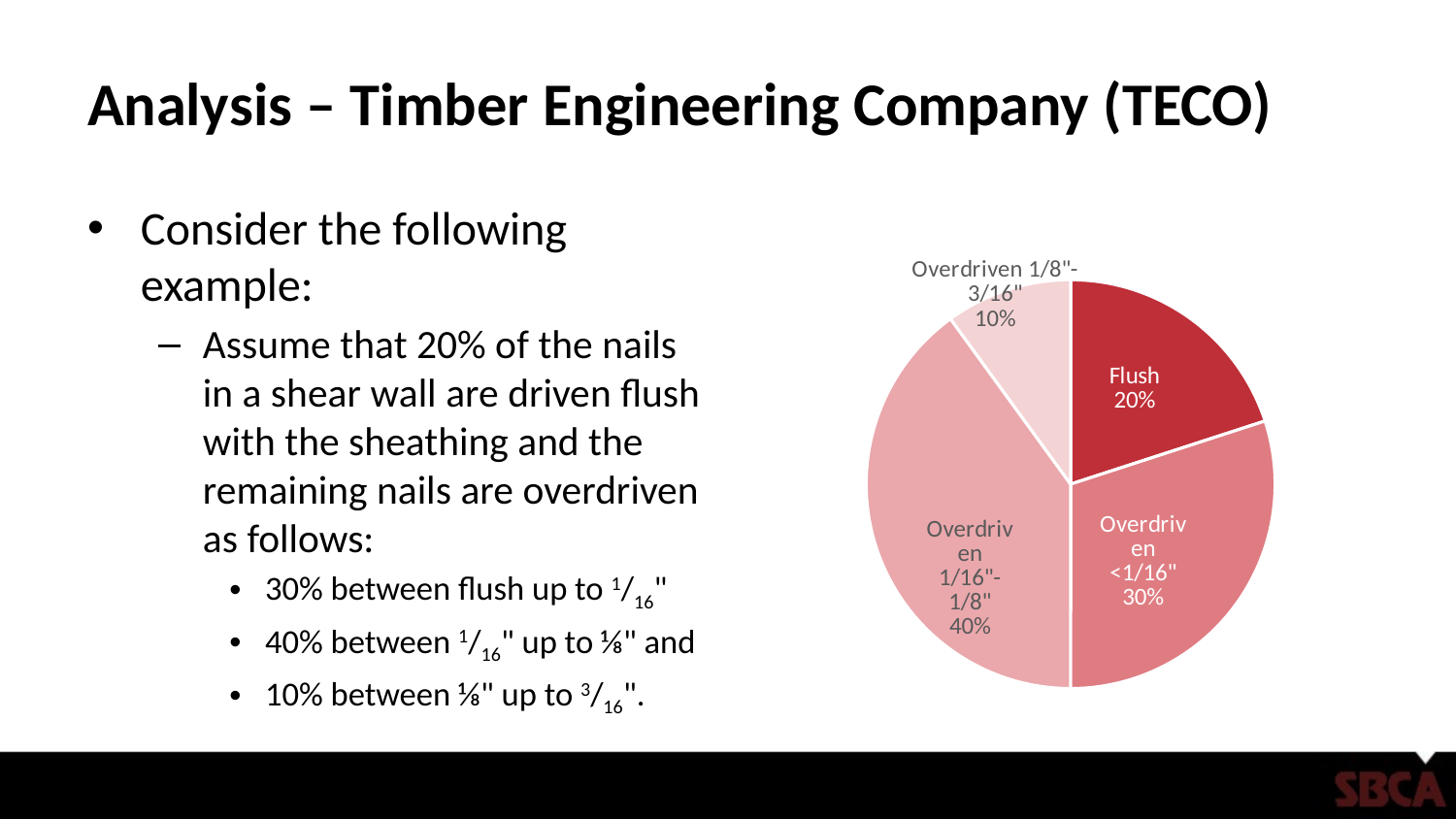
What is the difference in percentage points between the Overdriven 1/16"-1/8" slice and the Flush slice? 20 Which is larger, the Flush slice or the Overdriven <1/16" slice? Overdriven <1/16" Which slice of the pie chart is the smallest? Overdriven 1/8"-3/16" Which slice of the pie chart is the largest? Overdriven 1/16"-1/8" What is the combined share of all the Overdriven slices in the pie chart? 80% What percentage does the Overdriven 1/16"-1/8" slice show? 40% Which slice of the pie chart is drawn in the darkest red? Flush How many slices does the pie chart have? 4 What kind of chart is shown on the slide? pie chart What percentage does the Overdriven 1/8"-3/16" slice show? 10% What percentage does the Overdriven <1/16" slice show? 30% What percentage of nails are shown as Flush in the pie chart? 20%